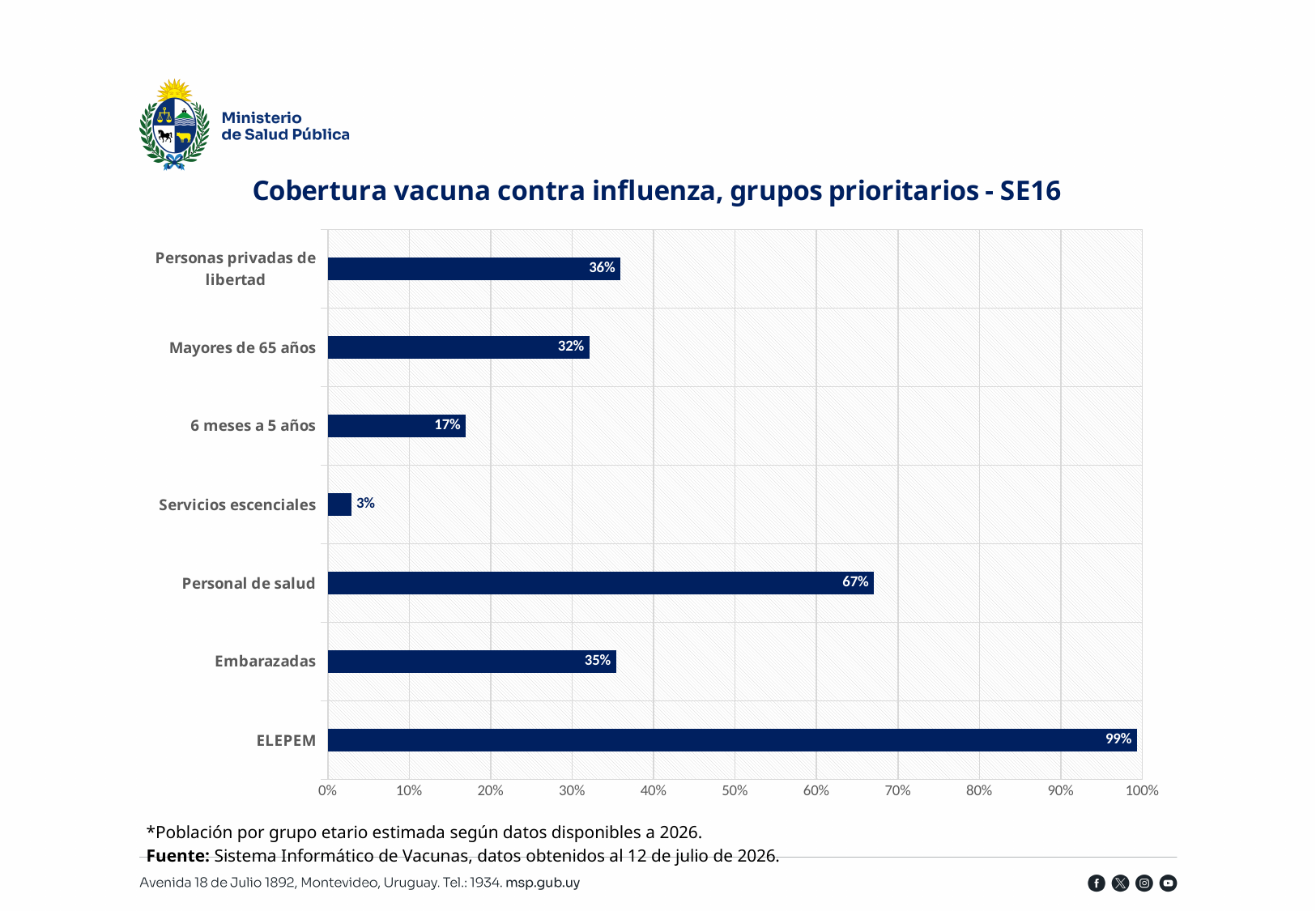
What is the title of the chart? Cobertura vacuna contra influenza, grupos prioritarios - SE16 What is the difference in coverage between ELEPEM and Personal de salud? 32% What is the difference in coverage between Personas privadas de libertad and Mayores de 65 años? 4% Which group has the highest vaccination coverage? ELEPEM How many priority groups are shown in the chart? 7 What is the vaccination coverage for Servicios escenciales? 3% What is the vaccination coverage for 6 meses a 5 años? 17% Which has higher coverage, Embarazadas or Mayores de 65 años? Embarazadas What is the vaccination coverage for ELEPEM? 99% What kind of chart is shown on the slide? Bar chart What is the vaccination coverage for Personal de salud? 67% Which group has the lowest vaccination coverage? Servicios escenciales